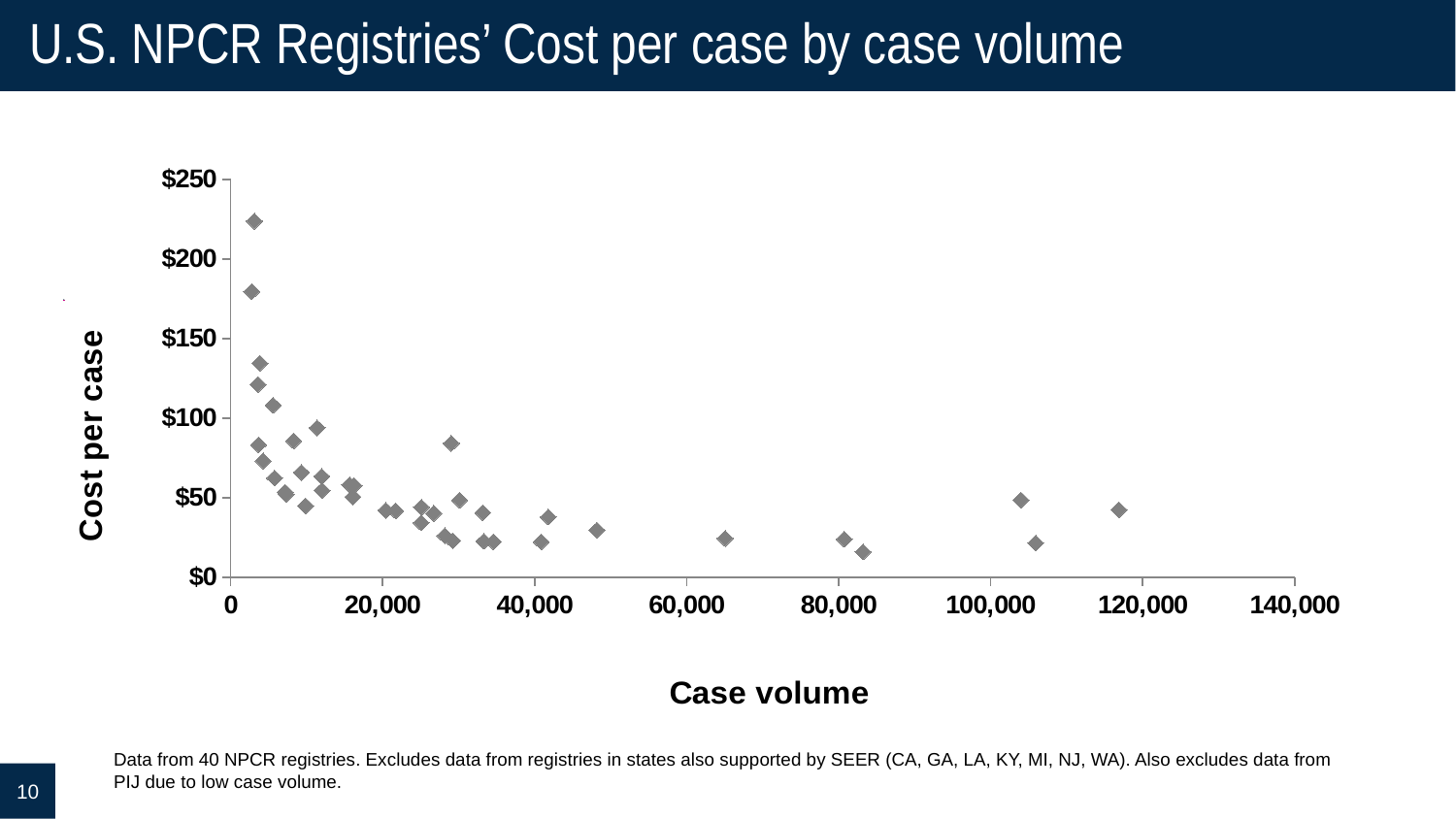
Is the highest cost per case shown on the chart greater or less than $200? greater What is the title of the chart? U.S. NPCR Registries' Cost per case by case volume What is the highest value shown on the y axis? $250 What kind of chart is shown on the slide? scatter chart Is the case volume of the registry with the highest cost per case greater or less than 20,000? less Is the lowest cost per case shown on the chart greater or less than $50? less According to the note below the chart, how many NPCR registries does the data come from? 40 As case volume increases along the x axis, does cost per case generally rise or fall? fall What is the label of the x axis? Case volume